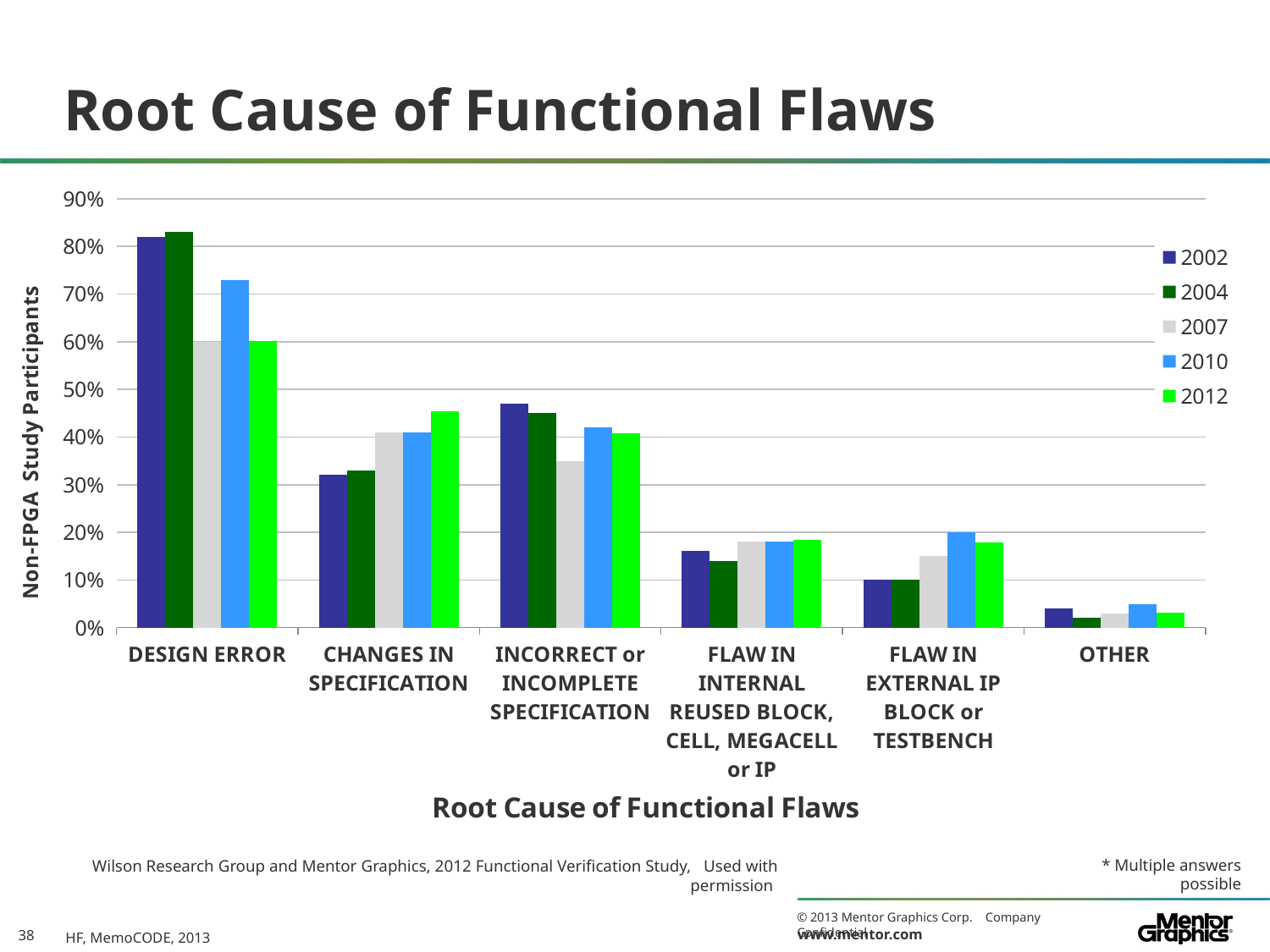
For DESIGN ERROR, which is larger: the 2010 value or the 2007 value? 2010 Is the 2002 value for DESIGN ERROR greater or less than 70%? greater Is the 2002 value for FLAW IN EXTERNAL IP BLOCK or TESTBENCH greater or less than 20%? less Is the 2007 value for DESIGN ERROR greater or less than 70%? less Which category has the highest value for 2002? DESIGN ERROR How many series does the legend list? 5 How many root-cause categories are shown on the x axis? 6 For INCORRECT or INCOMPLETE SPECIFICATION, which is larger: the 2002 value or the 2007 value? 2002 Which category has the lowest value for 2012? OTHER What kind of chart is shown on the slide? bar chart What is the label on the vertical axis of the chart? Non-FPGA Study Participants